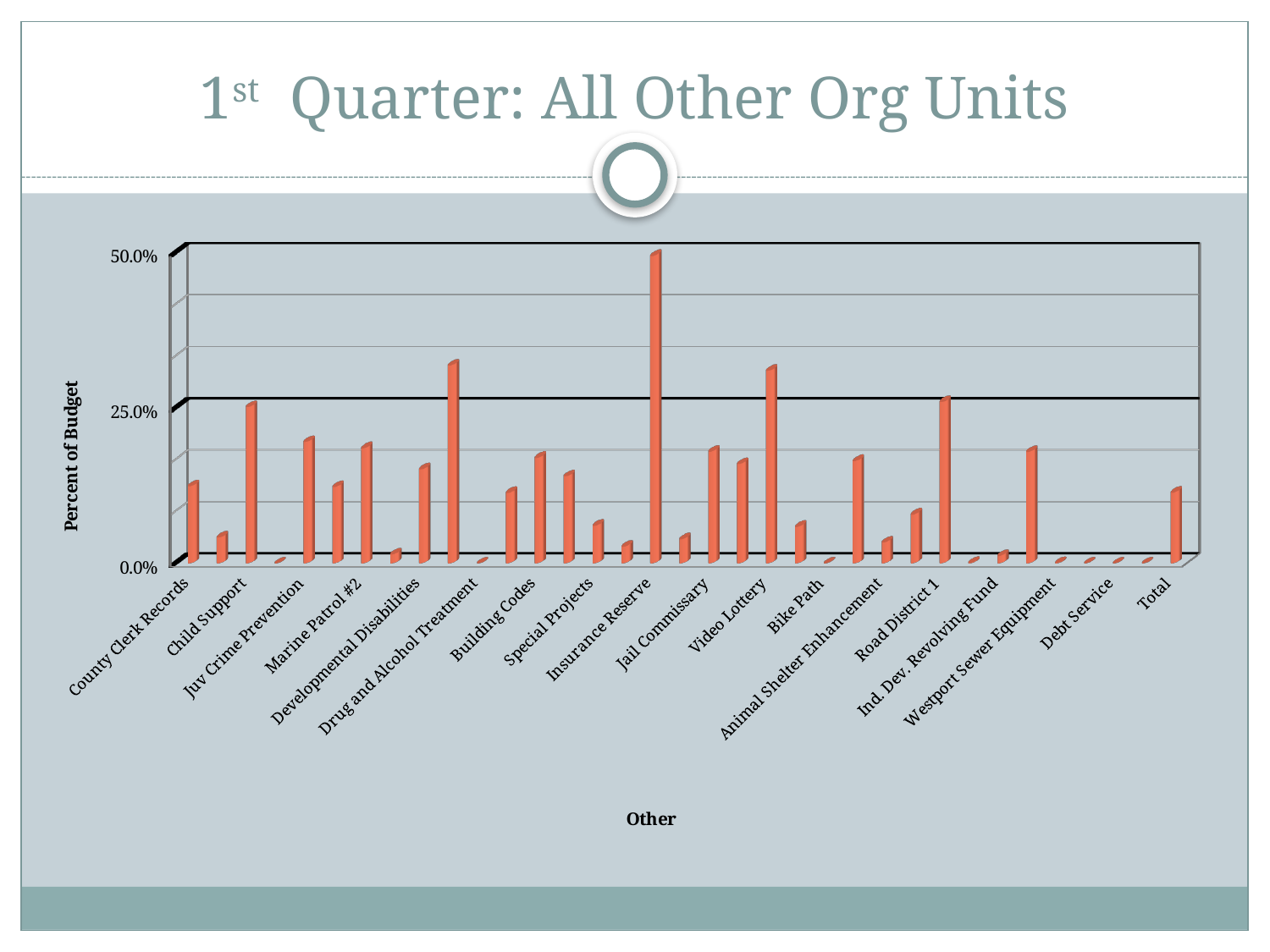
What is the title of the slide? 1st Quarter: All Other Org Units Is the value for County Clerk Records greater or less than 25.0%? less What kind of chart is shown on the slide? bar chart Which category has the highest percent of budget? Insurance Reserve Is the value for Insurance Reserve greater or less than 25.0%? greater Is the value for Jail Commissary greater or less than 25.0%? less Which is larger, the value for Insurance Reserve or the value for Video Lottery? Insurance Reserve Which is larger, the value for Building Codes or the value for Animal Shelter Enhancement? Building Codes Which is larger, the value for Juv Crime Prevention or the value for Special Projects? Juv Crime Prevention What is the title of the vertical axis? Percent of Budget